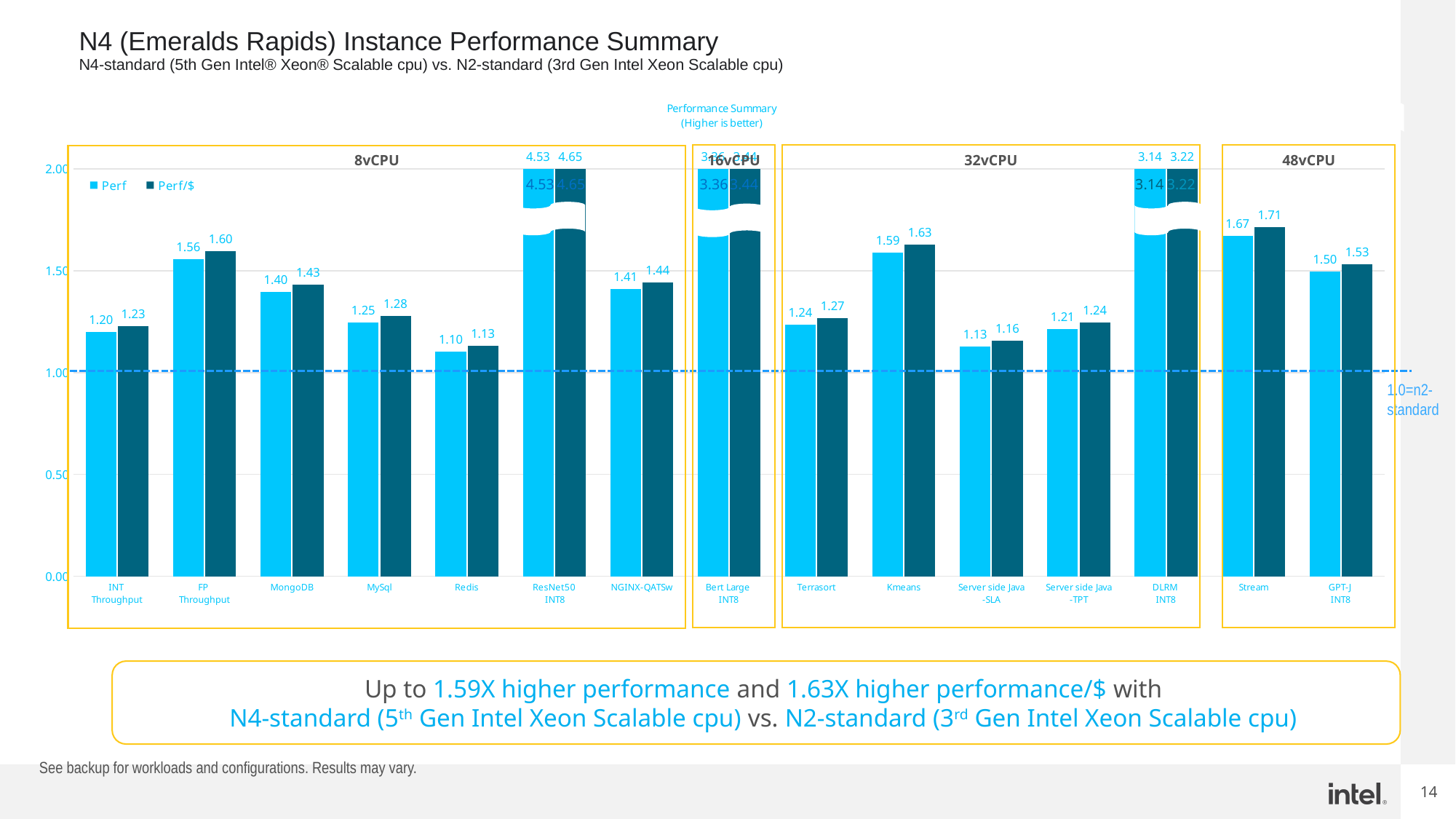
How many workloads are shown on the x axis of the chart? 15 What is the Perf/$ value for Stream? 1.71 Which workload has the highest Perf value? ResNet50 INT8 Which workload has the lowest Perf/$ value? Redis Is the Perf value for Terrasort greater or less than 1.50? less What is the Perf/$ value for Kmeans? 1.63 What is the Perf value for MongoDB? 1.40 How many series does the legend list? 2 Which is larger, the Perf value for FP Throughput or the Perf value for GPT-J INT8? FP Throughput What is the Perf value for Bert Large INT8? 3.36 What is the difference between the Perf/$ and Perf values for DLRM INT8? 0.08 What kind of chart is shown on the slide? bar chart